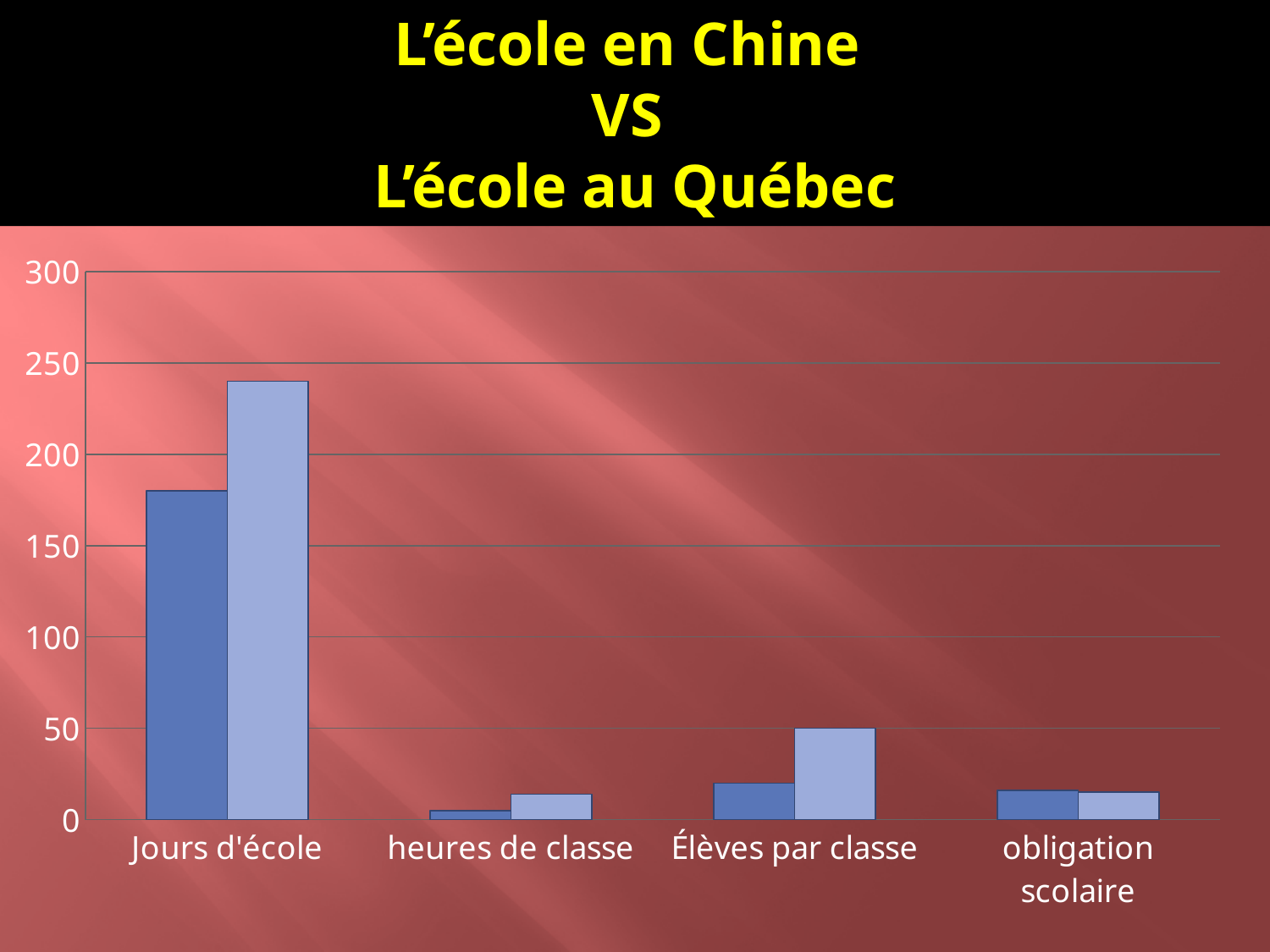
Which category has the tallest bar in the chart? Jours d'école Which category has the shortest bar in the chart? heures de classe How many bars are plotted for each category in the chart? 2 Is the light blue bar for heures de classe greater or less than 50? less Is the dark blue bar for Jours d'école greater or less than 200? less What kind of chart is shown on the slide? bar chart What is the title of the slide containing the chart? L'école en Chine VS L'école au Québec For Élèves par classe, which bar is taller, the dark blue one or the light blue one? the light blue one How many categories are shown on the x axis of the chart? 4 For Jours d'école, which bar is taller, the dark blue one or the light blue one? the light blue one Is the light blue bar for Jours d'école greater or less than 200? greater